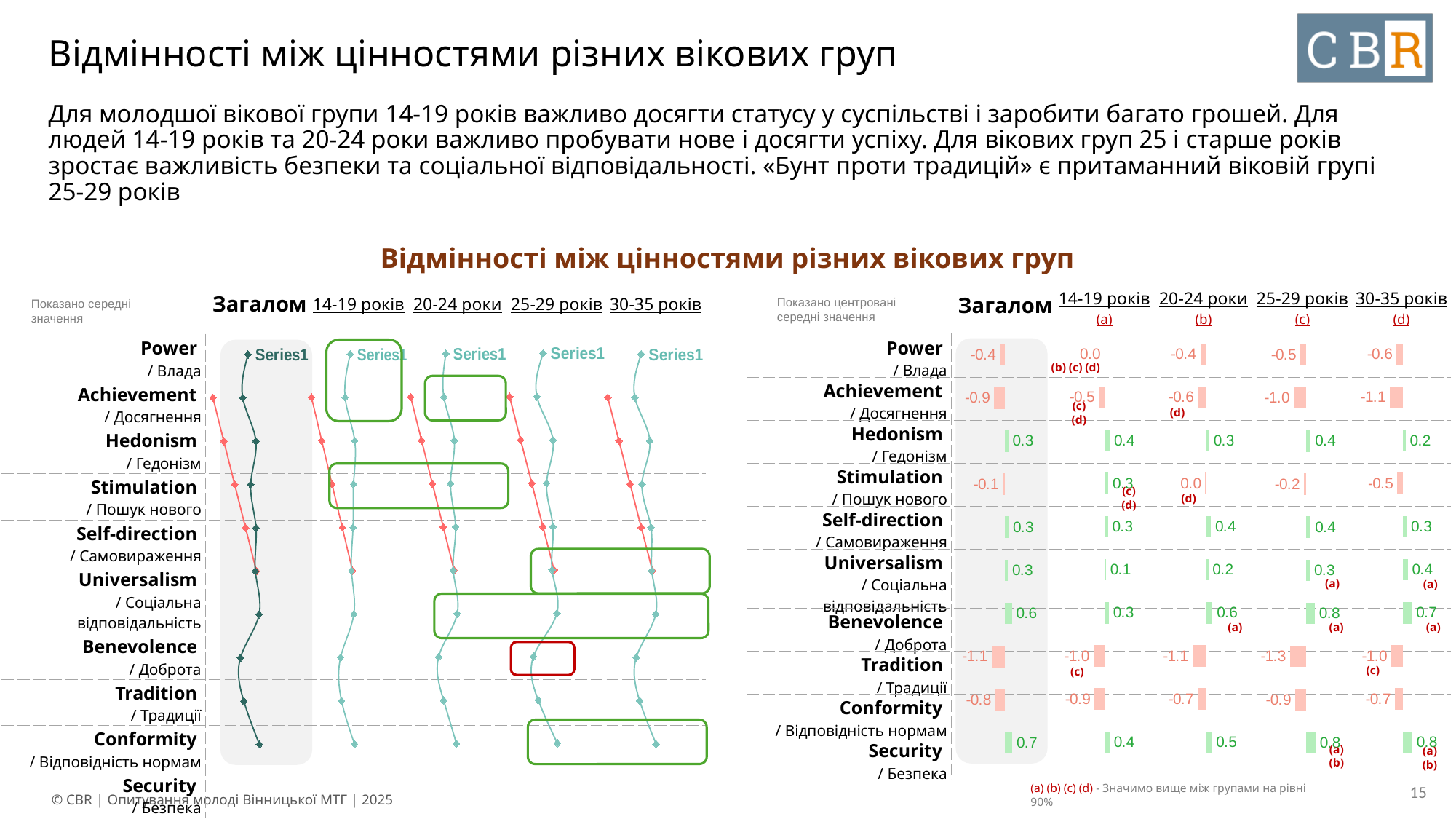
In the right-hand chart of centered mean values, which is larger for Achievement: the 14-19 років value or the 30-35 років value? 14-19 років How many age-group columns (excluding Загалом) are shown in the right-hand chart of centered mean values? 4 In the right-hand chart of centered mean values, what is the value for Stimulation in the 20-24 роки column? 0.0 In the right-hand chart of centered mean values, what is the value for Security in the 30-35 років column? 0.8 In the right-hand chart of centered mean values, which is larger for Stimulation: the 14-19 років value or the 30-35 років value? 14-19 років How many value categories (rows) are plotted in the right-hand chart of centered mean values? 10 In the right-hand chart of centered mean values, what is the value for Power in the 14-19 років column? 0.0 In the right-hand chart of centered mean values, which value category has the lowest value in the 25-29 років column? Tradition In the right-hand chart of centered mean values, what is the value for Tradition in the Загалом (overall) column? -1.1 In the right-hand chart of centered mean values, what is the difference between the Benevolence values for 25-29 років (0.8) and 14-19 років (0.3)? 0.5 In the right-hand chart of centered mean values, which value category has the highest value in the Загалом (overall) column? Security What kind of chart is used on the left-hand side of the slide to show the mean values for each age group? Line chart